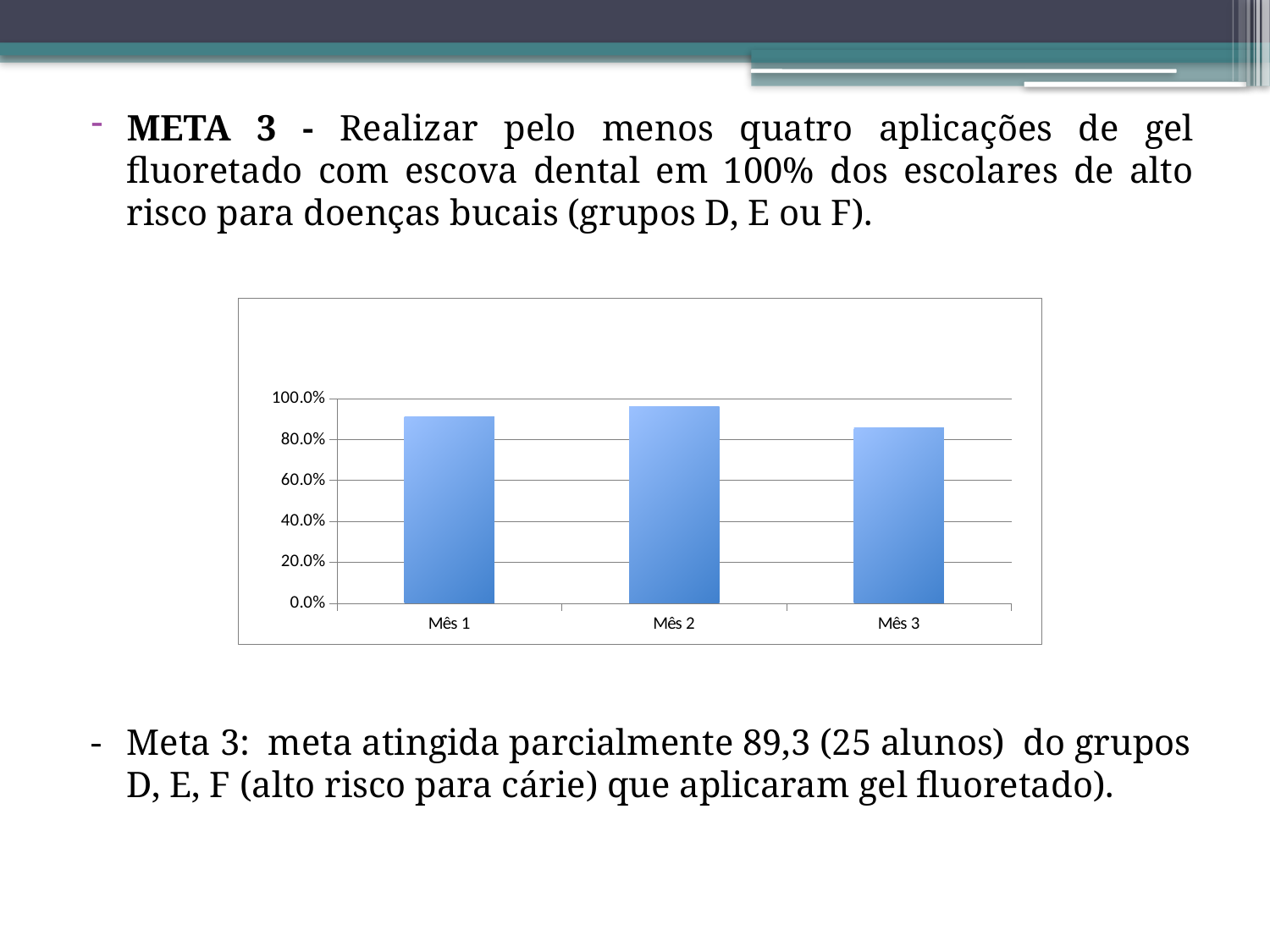
Is the value for Mês 2 greater or less than 100.0%? less Is the value for Mês 3 greater or less than 80.0%? greater Which month has the highest bar in the chart? Mês 2 Which is larger, the value for Mês 2 or the value for Mês 1? Mês 2 Do the values rise or fall from Mês 2 to Mês 3? fall Which month has the lowest bar in the chart? Mês 3 How many categories are plotted on the x axis of the chart? 3 What kind of chart is shown on the slide? bar chart What is the highest value shown on the y axis of the chart? 100.0% Is the value for Mês 1 greater or less than 80.0%? greater Which is larger, the value for Mês 1 or the value for Mês 3? Mês 1